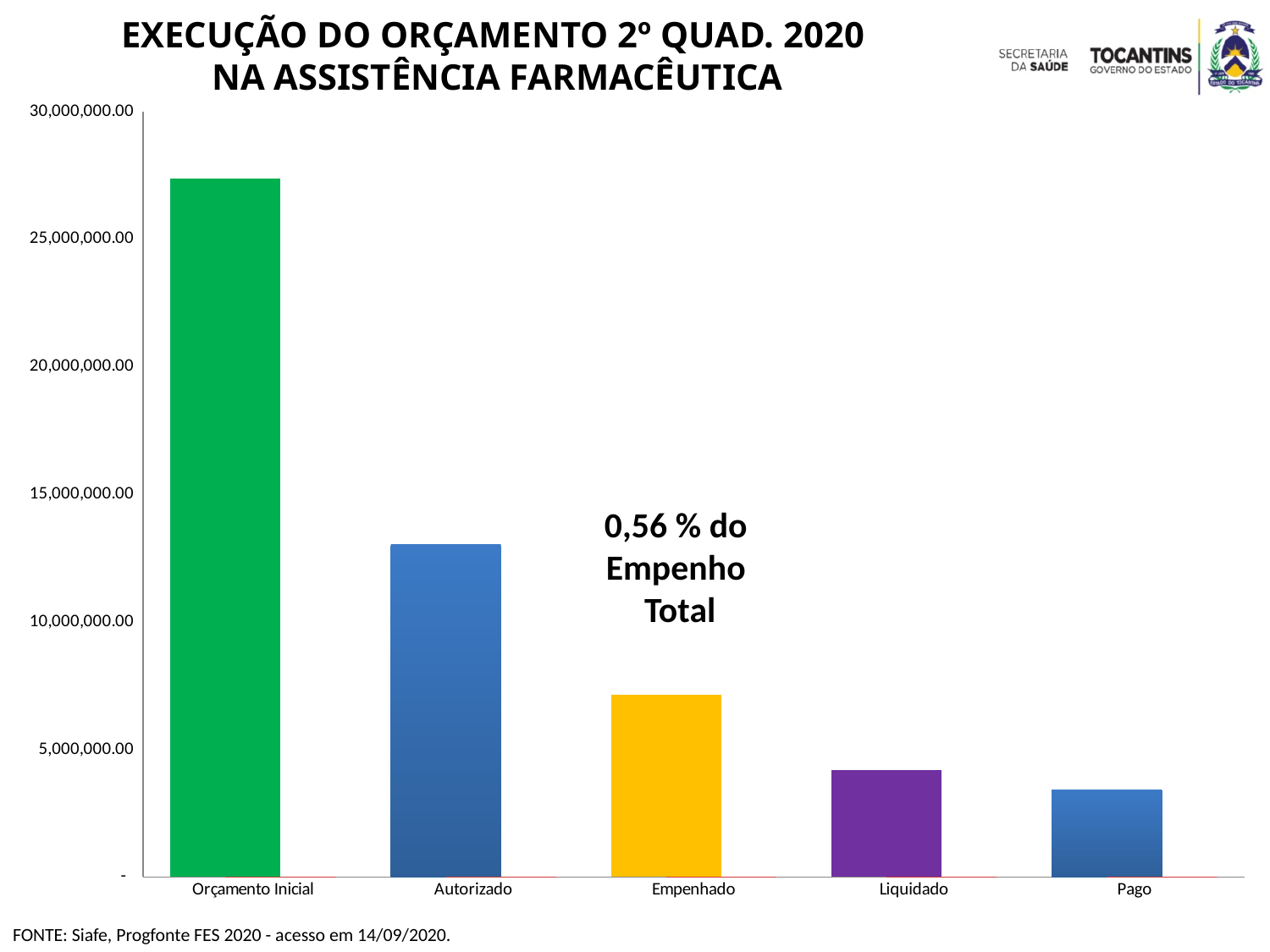
How many categories are plotted on the x axis? 5 Is the value for Autorizado greater or less than 15,000,000.00? less Do the values rise or fall moving from left to right along the x axis? fall Is the value for Orçamento Inicial greater or less than 25,000,000.00? greater What kind of chart is shown on the slide? Bar chart Which category has the highest value? Orçamento Inicial Is the value for Empenhado greater or less than 5,000,000.00? greater Which is larger, the value for Liquidado or the value for Pago? Liquidado Which category has the lowest value? Pago What percentage annotation is printed above the Empenhado bar? 0,56 % do Empenho Total Which is larger, the value for Autorizado or the value for Empenhado? Autorizado